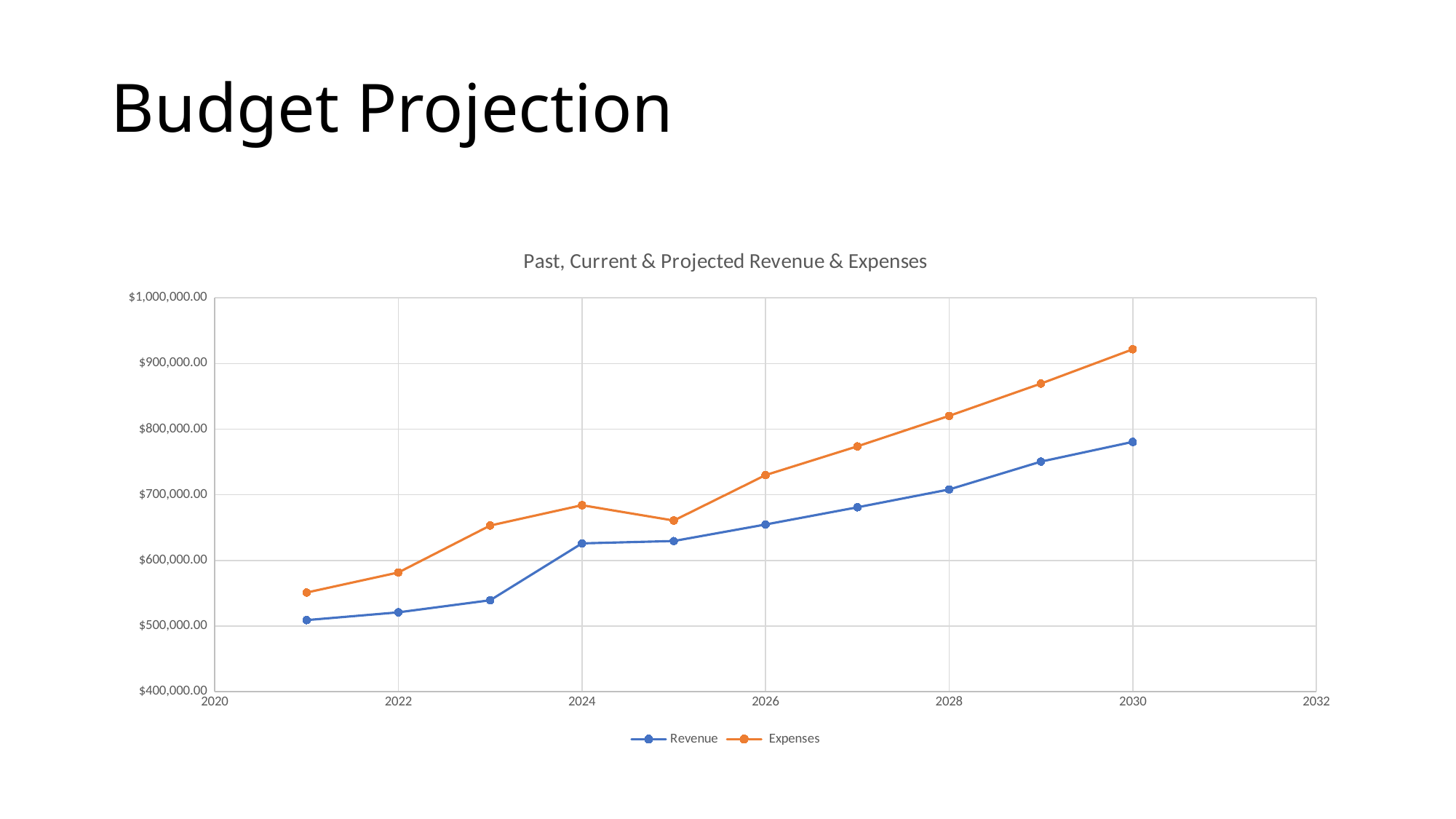
What is the title of the chart? Past, Current & Projected Revenue & Expenses Is the value for Expenses in 2030 greater or less than $900,000.00? greater Does the Revenue series generally rise or fall from 2021 to 2030? Rise Is the value for Revenue in 2030 greater or less than $800,000.00? less In 2030, which is larger, Revenue or Expenses? Expenses In which year is Revenue at its lowest? 2021 What kind of chart is shown on the slide? Line chart Is the value for Revenue in 2024 greater or less than $600,000.00? greater In which year is Expenses at its highest? 2030 How many series does the legend list? 2 Between 2024 and 2025, does the Expenses series rise or fall? Fall How many data points does the Revenue series have? 10